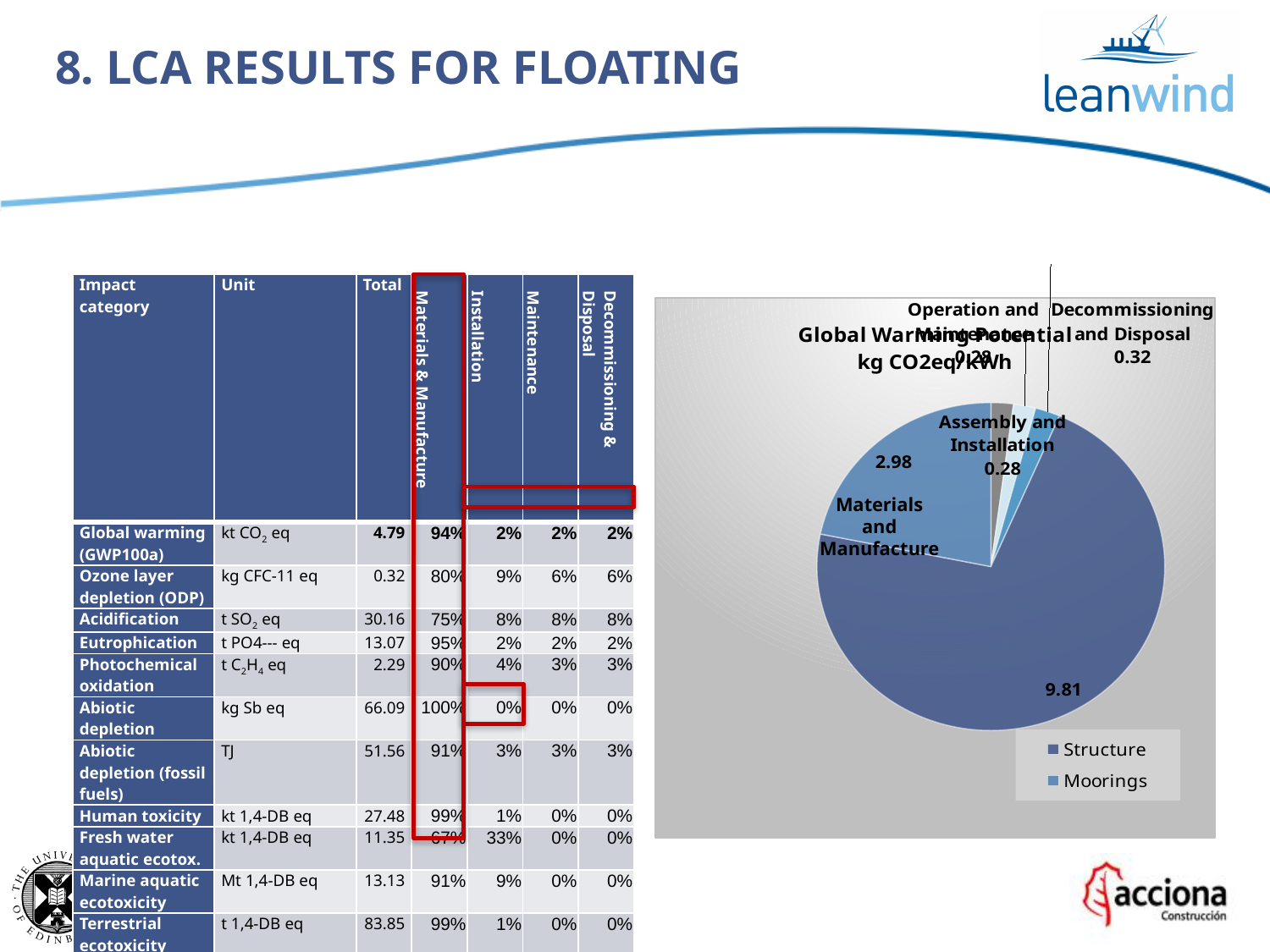
What is the title of the pie chart? Global Warming Potential kg CO2eq/kWh In the pie chart, what is the difference between the Structure value (9.81) and the Moorings value (2.98)? 6.83 Which slice of the pie chart is the largest? Structure What kind of chart is shown on the right side of the slide? pie chart What value is shown for Assembly and Installation in the pie chart? 0.28 Which two entries appear in the pie chart's legend? Structure and Moorings How many entries does the pie chart's legend list? 2 What value is labelled on the largest slice of the pie chart? 9.81 In the pie chart, what is the difference between the Moorings value (2.98) and the Decommissioning and Disposal value (0.32)? 2.66 What value is shown for the Moorings slice in the pie chart? 2.98 What value is shown for Decommissioning and Disposal in the pie chart? 0.32 In the pie chart, which is larger: the Moorings slice or the Decommissioning and Disposal slice? Moorings